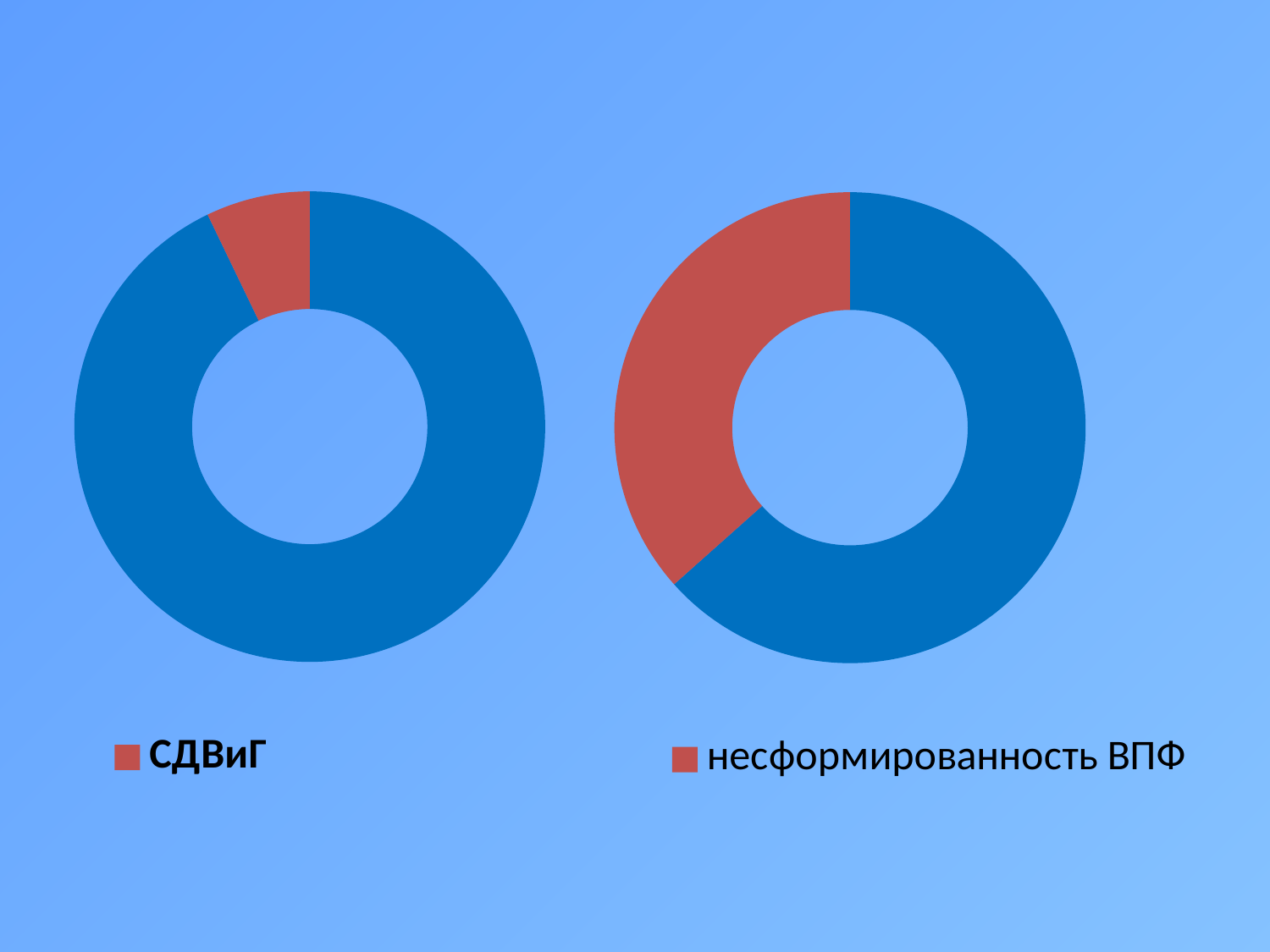
How many entries does the legend of the right chart list? 1 What type of chart is shown on the left of the slide? doughnut chart In the right chart, which slice is larger, the red one or the blue one? blue Which chart has the larger red slice, the left chart or the right chart? right chart How many slices does the left chart have? 2 In the left chart, which slice is larger, the red one or the blue one? blue In the left chart, which slice is the smallest? СДВиГ In the left chart, what is the legend entry shown for the red slice? СДВиГ How many slices does the right chart have? 2 In the right chart, what is the legend entry shown for the red slice? несформированность ВПФ What type of chart is shown on the right of the slide? doughnut chart How many entries does the legend of the left chart list? 1